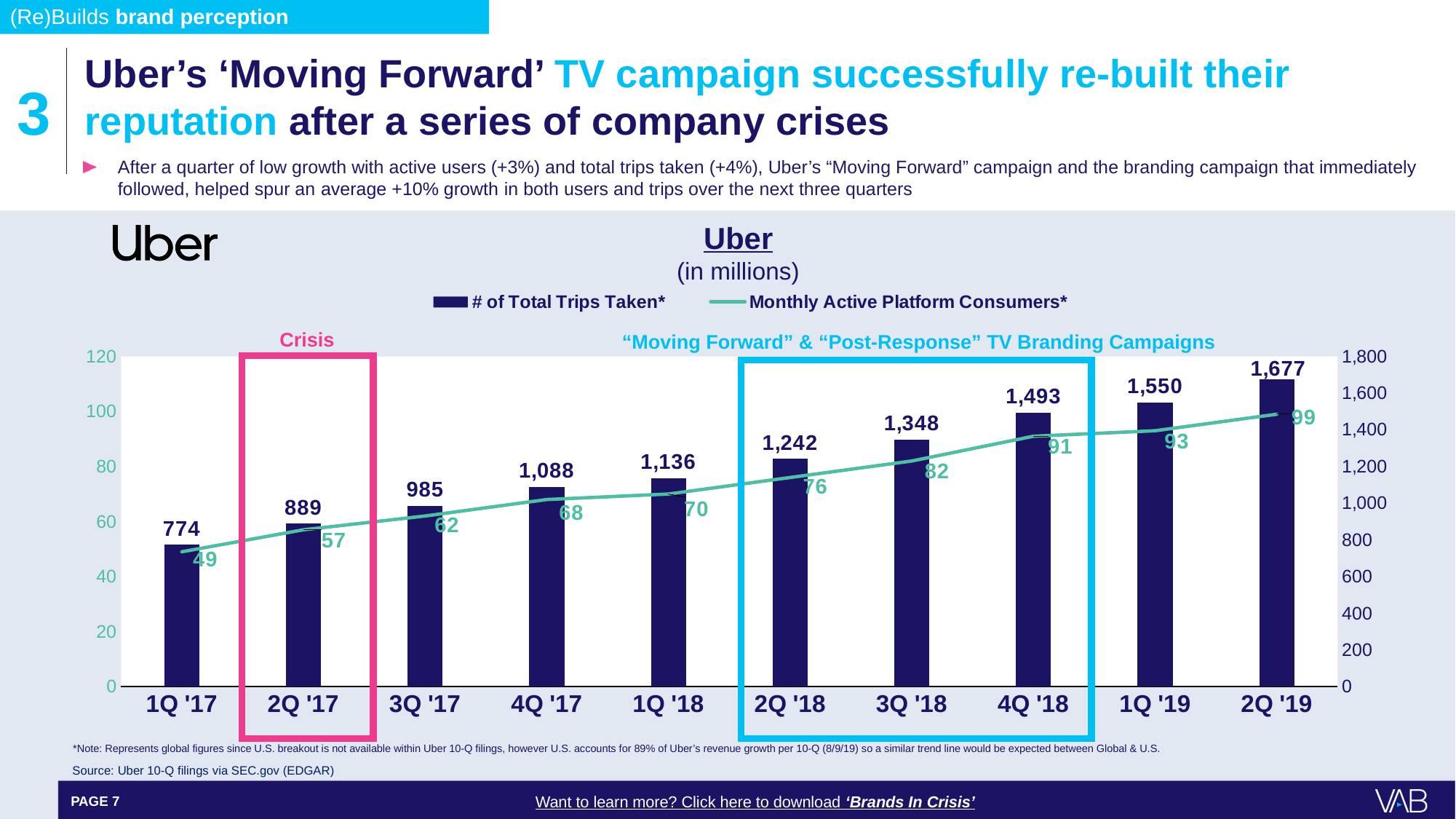
What is the difference in Monthly Active Platform Consumers between 2Q '18 and 1Q '18? 6 What is the # of Total Trips Taken for 2Q '17? 889 Which quarter has the highest Monthly Active Platform Consumers value? 2Q '19 How many quarters are shown on the x axis? 10 Which quarter is highlighted with the pink 'Crisis' box? 2Q '17 Which is larger, the # of Total Trips Taken in 3Q '18 or in 4Q '17? 3Q '18 How many series does the legend list? 2 What is the Monthly Active Platform Consumers value for 4Q '18? 91 Which quarter has the lowest # of Total Trips Taken? 1Q '17 Do the # of Total Trips Taken values rise or fall from 1Q '17 to 2Q '19? rise What is the difference in # of Total Trips Taken between 2Q '19 and 1Q '19? 127 What is the # of Total Trips Taken for 2Q '19? 1,677